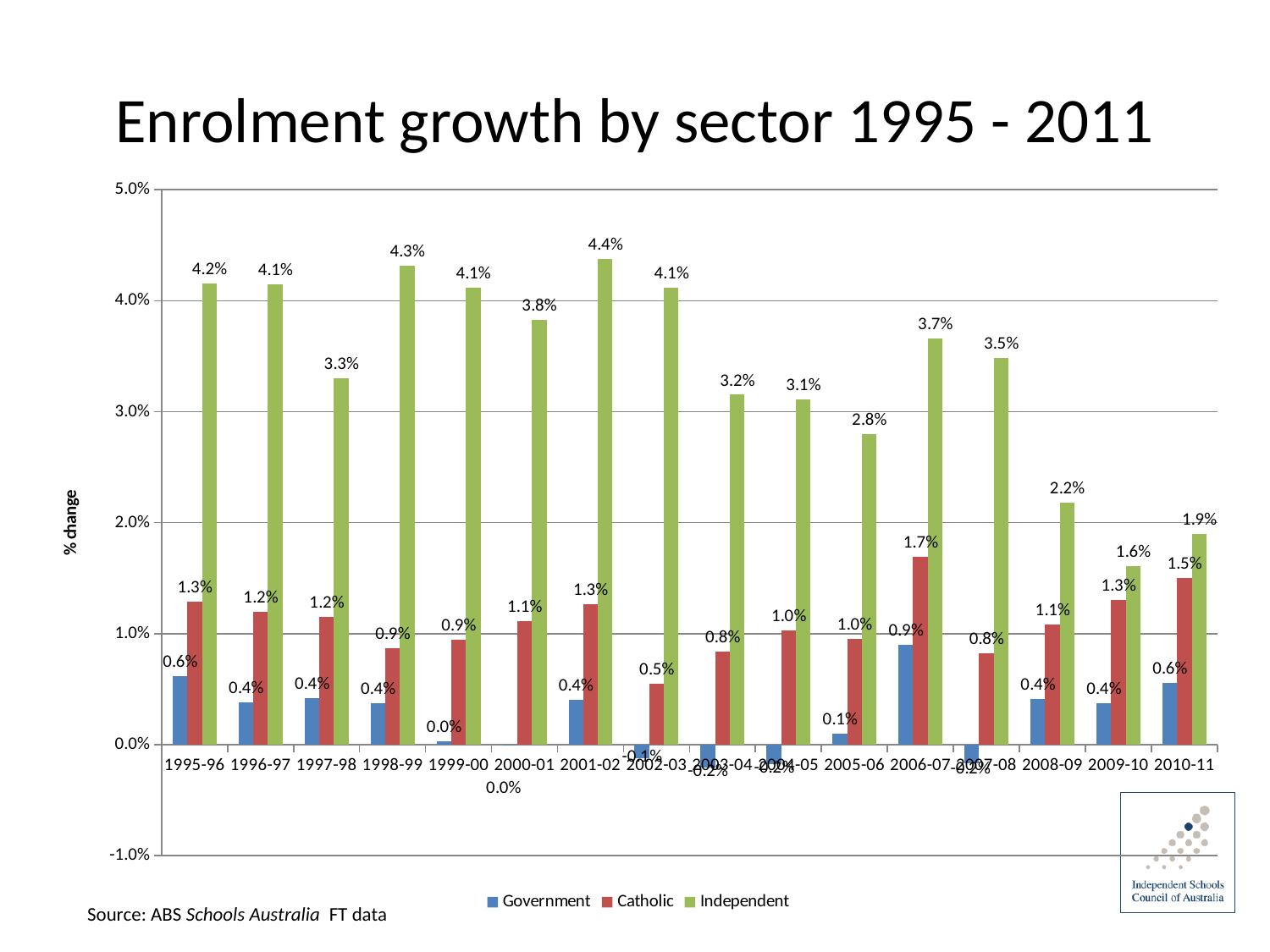
In which year is the Independent sector's enrolment growth highest? 2001-02 What is the Catholic enrolment growth for 2006-07? 1.7% What kind of chart is shown on the slide? Bar chart Which sector had higher enrolment growth in 2010-11, Government or Catholic? Catholic What is the label on the vertical axis? % change In which year is the Independent sector's enrolment growth lowest? 2009-10 How many series does the legend list? 3 Is the Independent growth value for 2005-06 greater or less than 3.0%? less How many year periods are shown on the x axis? 16 What is the difference between the Independent and Catholic growth rates in 1995-96? 2.9% What is the Government enrolment growth for 1995-96? 0.6% What is the Independent enrolment growth for 2001-02? 4.4%